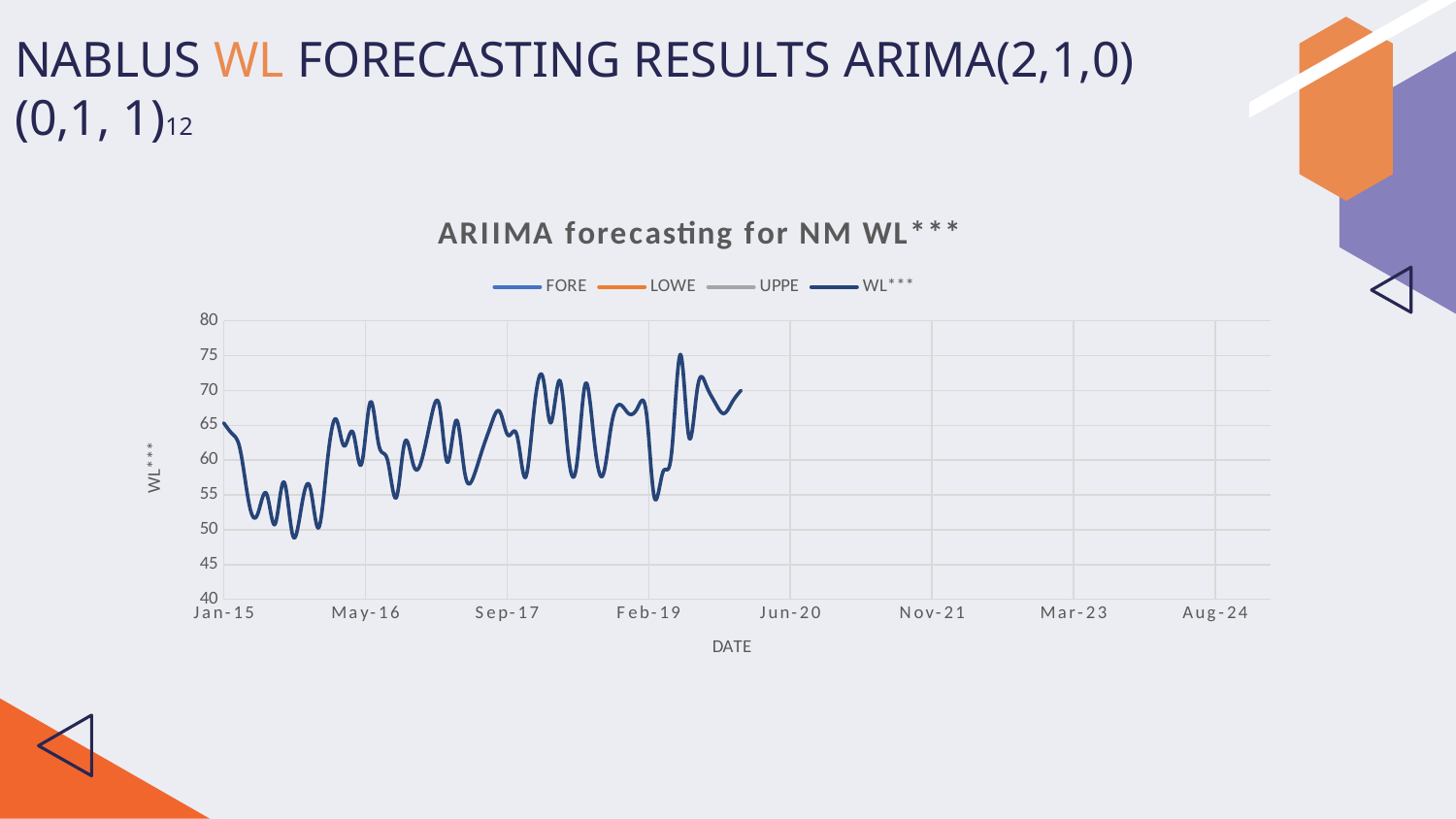
How many series does the chart legend list? 4 Is the lowest point of the WL*** line greater or less than 50? less Is the WL*** value at Jan-15 greater or less than 60? greater What is the title of the chart? ARIIMA forecasting for NM WL*** What kind of chart is shown on the slide? line chart How many date labels are shown on the x axis? 8 What is the lowest value shown on the y axis? 40 Which legend series is the only one visibly plotted on the chart? WL*** What is the highest value shown on the y axis? 80 Is the WL*** value at Jan-15 greater or less than 70? less